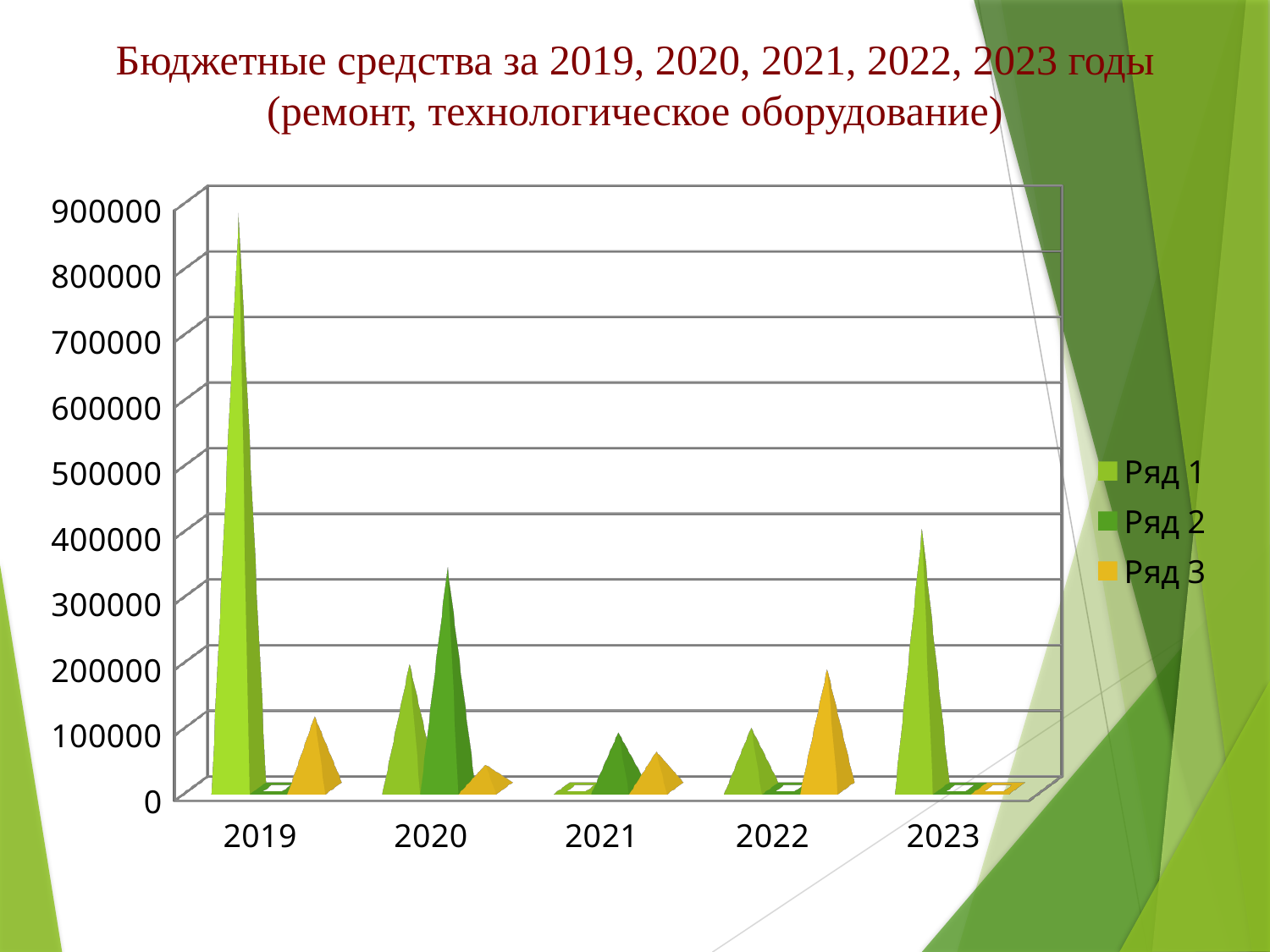
In which year is the value for Ряд 2 the highest? 2020 How many series does the legend list? 3 In 2020, which series has the larger value, Ряд 1 or Ряд 2? Ряд 2 In which year is the value for Ряд 1 the highest? 2019 How many years (categories) are shown on the x axis? 5 What is the first line of the chart's title? Бюджетные средства за 2019, 2020, 2021, 2022, 2023 годы Is the value for Ряд 2 in 2020 greater or less than 300000? greater Is the value for Ряд 1 in 2020 greater or less than 300000? less Is the value for Ряд 1 in 2019 greater or less than 800000? greater What kind of chart is shown on the slide? bar chart In which year is the value for Ряд 3 the highest? 2022